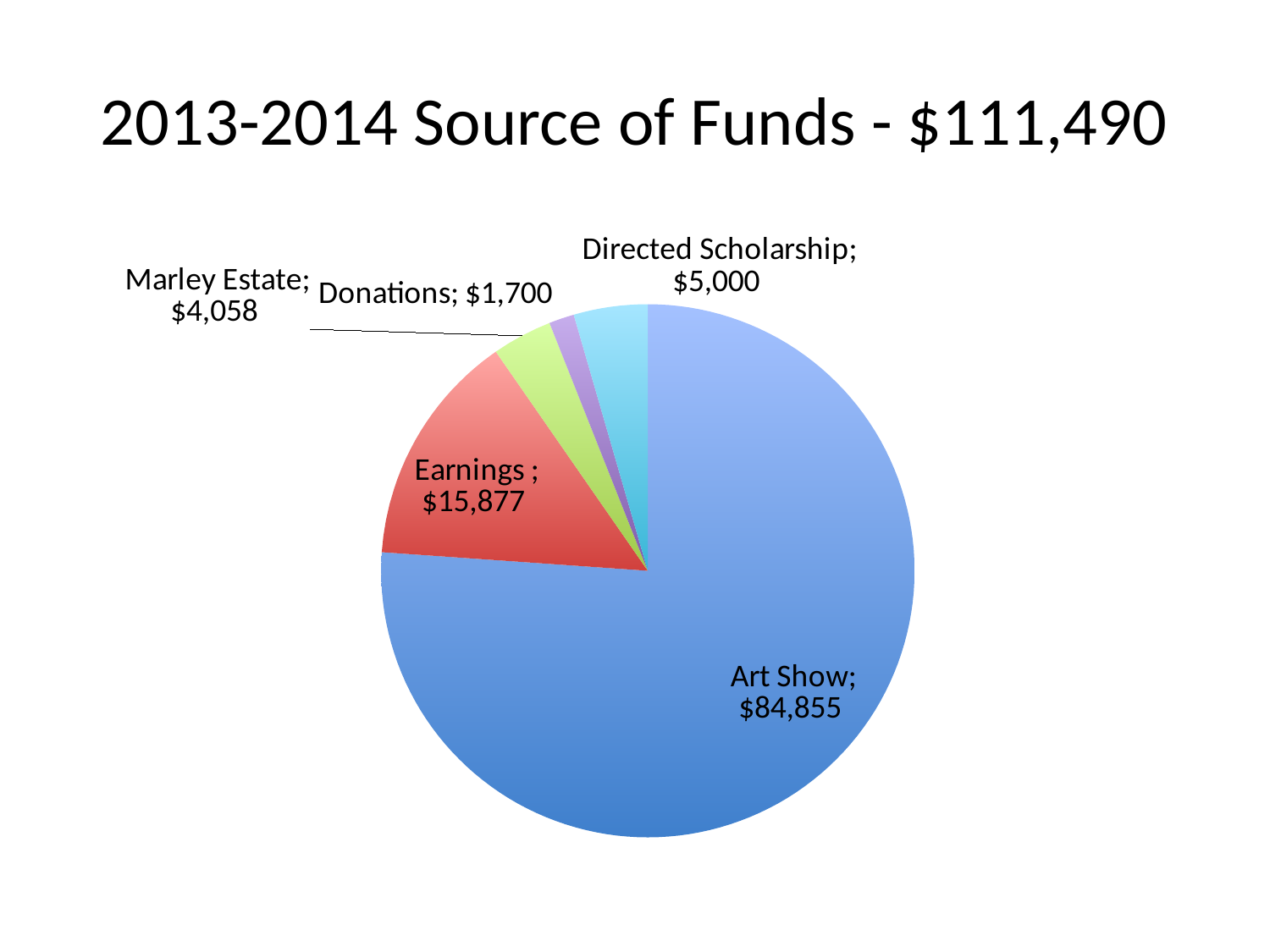
What is the value for Art Show? $84,855 What kind of chart is shown on the slide? pie chart What is the value for Marley Estate? $4,058 What is the value for Earnings? $15,877 Which is larger, Directed Scholarship or Marley Estate? Directed Scholarship How many slices does the pie chart have? 5 What is the value for Directed Scholarship? $5,000 What is the title of the chart? 2013-2014 Source of Funds - $111,490 What is the difference between the Art Show and Earnings values? $68,978 Which source of funds is the smallest? Donations Which source of funds is the largest? Art Show What share of the total funds does Art Show represent, to one decimal place? 76.1%